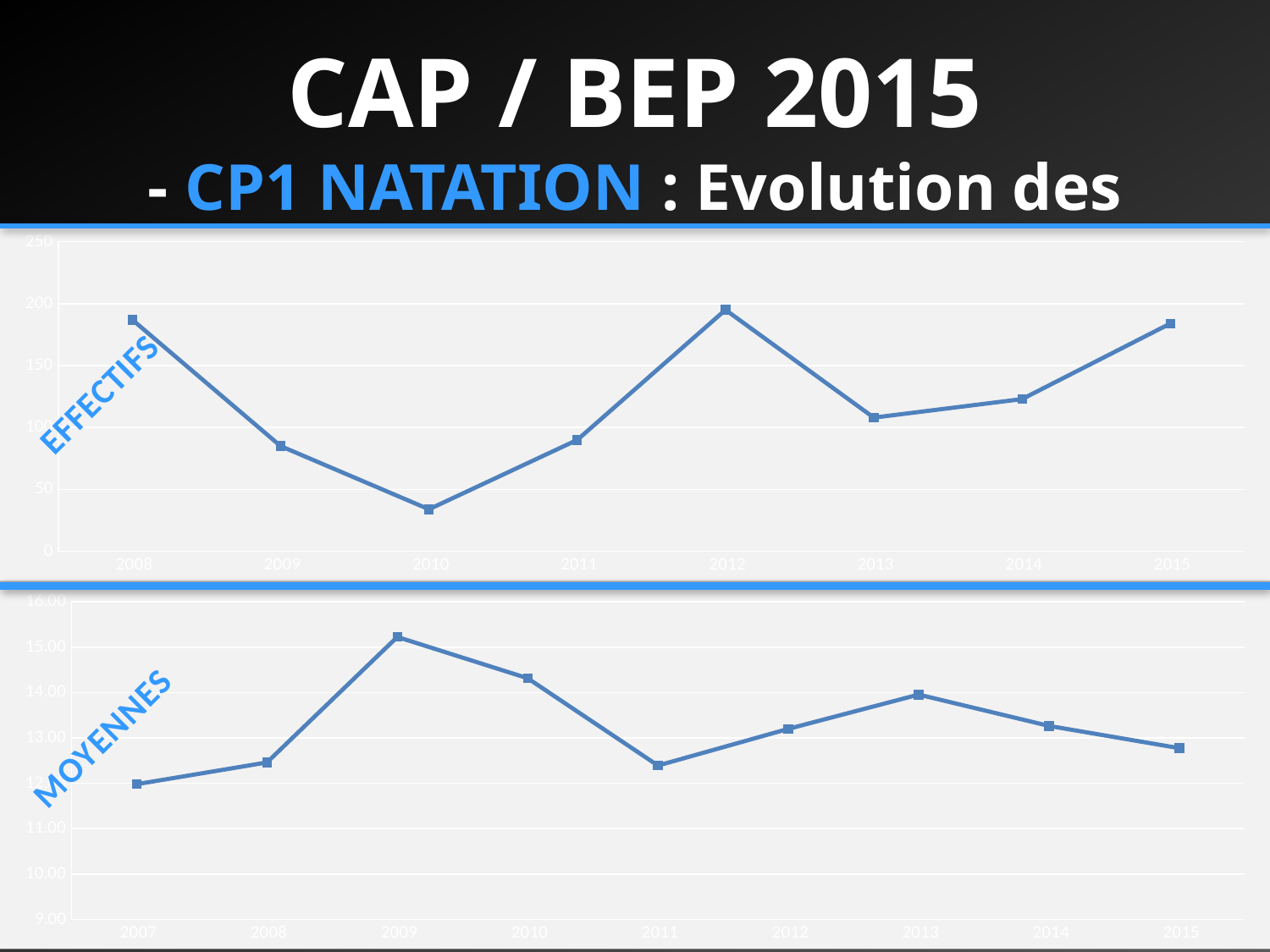
In the bottom chart (MOYENNES), do the values rise or fall from 2009 to 2011? fall In the bottom chart (MOYENNES), which year has the highest value? 2009 In the bottom chart (MOYENNES), how many years are plotted on the x axis? 9 In the top chart (EFFECTIFS), which is larger, the value for 2013 or the value for 2014? 2014 In the top chart (EFFECTIFS), is the value for 2010 greater or less than 50? less In the top chart (EFFECTIFS), is the value for 2012 greater or less than 150? greater In the bottom chart (MOYENNES), which is larger, the value for 2013 or the value for 2014? 2013 What kind of chart is the top chart labelled EFFECTIFS? line chart In the top chart (EFFECTIFS), which year has the lowest value? 2010 In the bottom chart (MOYENNES), is the value for 2009 greater or less than 15.00? greater In the top chart (EFFECTIFS), do the values rise or fall from 2012 to 2013? fall In the top chart (EFFECTIFS), how many years are plotted on the x axis? 8